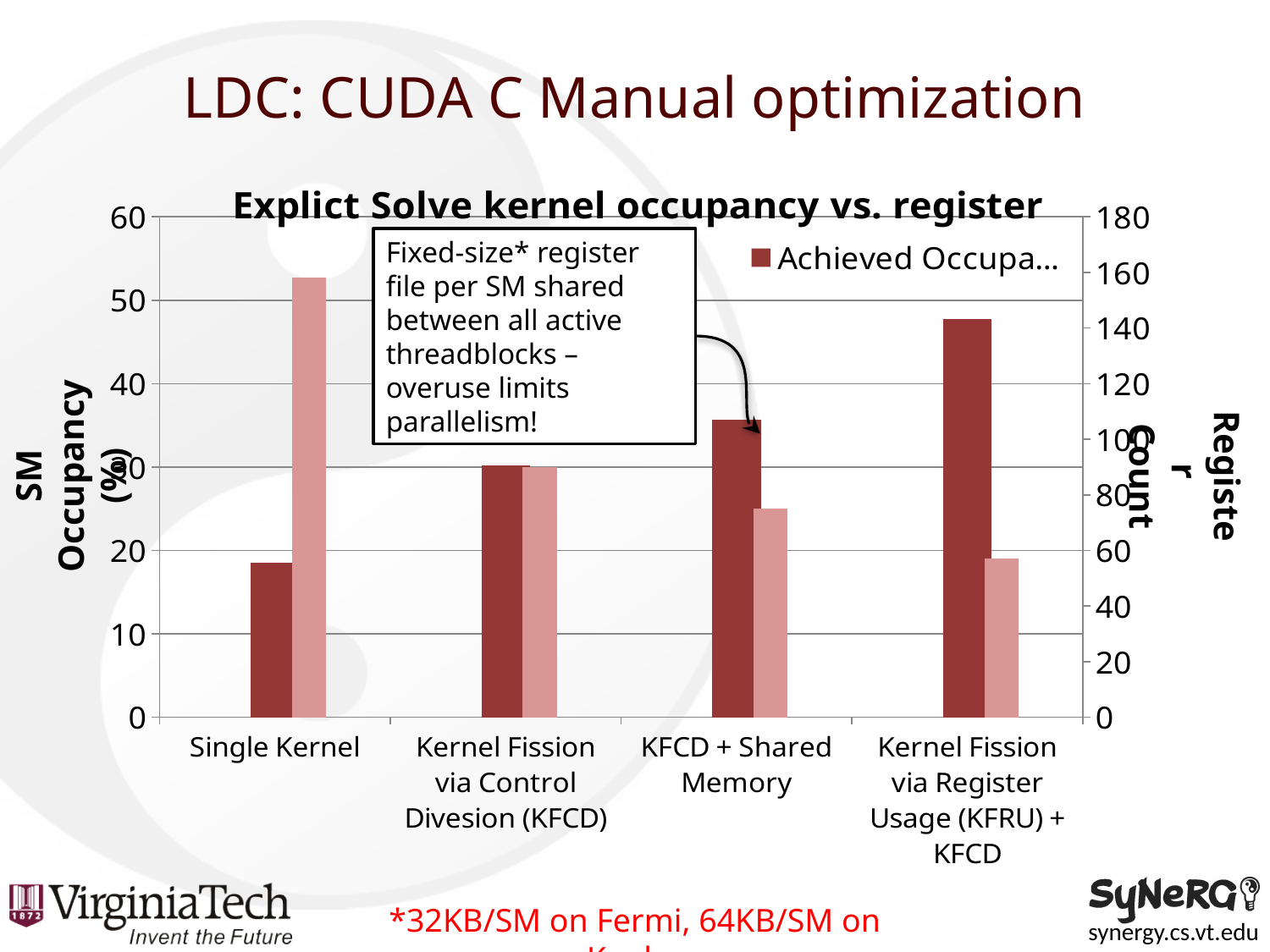
Is the Achieved Occupancy value for Kernel Fission via Register Usage (KFRU) + KFCD greater or less than 40? greater Do the Achieved Occupancy values rise or fall from left to right across the categories? rise Is the Achieved Occupancy value for Single Kernel greater or less than 20? less What kind of chart is shown on the slide? bar chart Which has a higher Achieved Occupancy: Single Kernel or KFCD + Shared Memory? KFCD + Shared Memory Which category has the lowest Achieved Occupancy (dark red bar)? Single Kernel Is the Achieved Occupancy value for KFCD + Shared Memory greater or less than 30? greater Which category has the tallest light pink bar (register count, right axis)? Single Kernel Which category has the highest Achieved Occupancy (dark red bar)? Kernel Fission via Register Usage (KFRU) + KFCD How many categories are shown along the x axis of the chart? 4 What is the title of the left vertical axis? SM Occupancy (%)